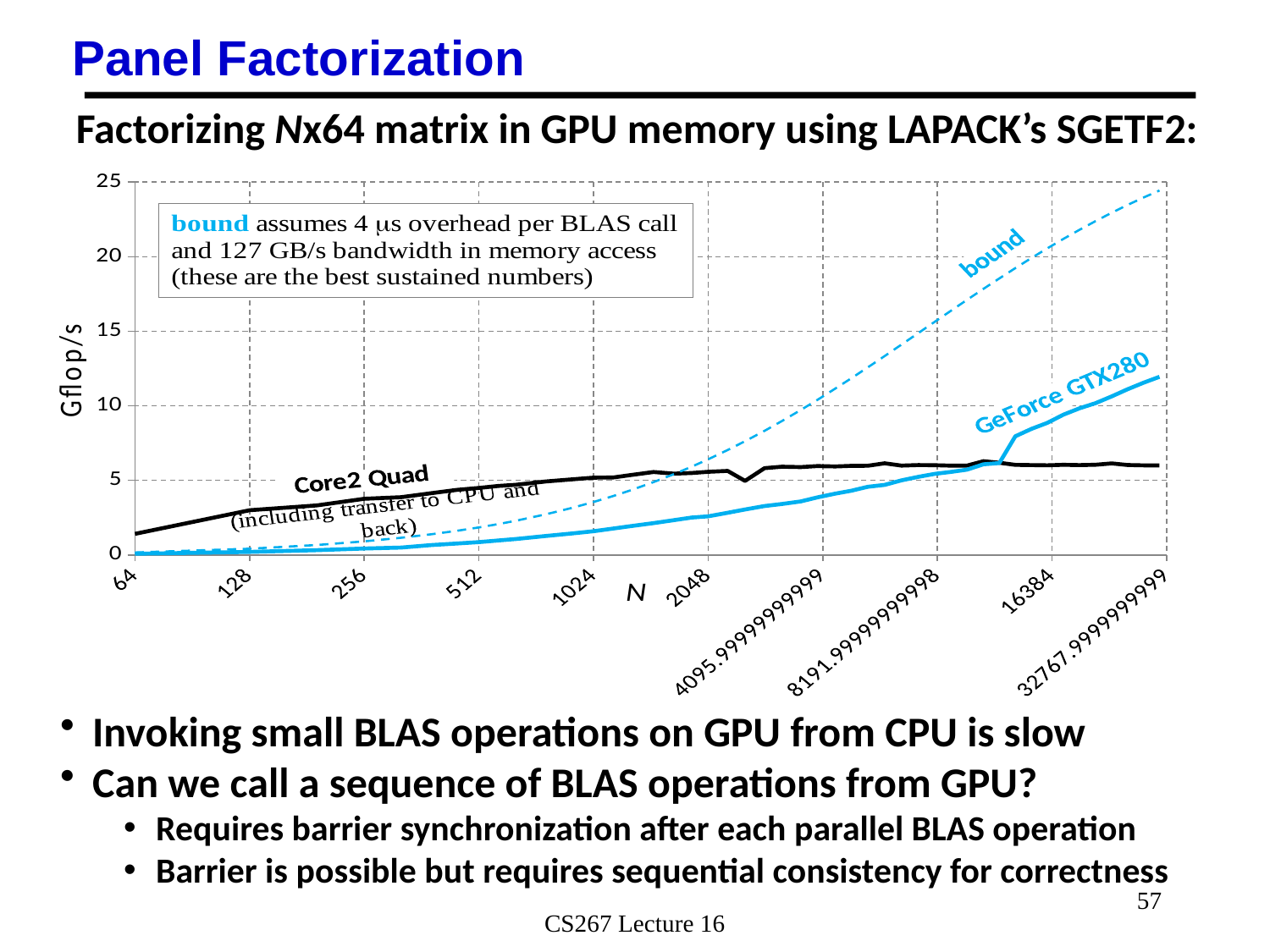
At N = 64, which series has the higher value: Core2 Quad or GeForce GTX280? Core2 Quad Is the value of the bound series at N = 8191.9999999998 greater or less than 15 Gflop/s? greater Is the value of the Core2 Quad series at N = 64 greater or less than 5 Gflop/s? less Is the value of the bound series at the largest N (32767.9999999999) greater or less than 20 Gflop/s? greater How many series are plotted on the chart? 3 At N = 16384, which series has the higher value: GeForce GTX280 or Core2 Quad? GeForce GTX280 What is the label of the x axis? N Does the GeForce GTX280 series rise or fall as N increases? rise What kind of chart is shown on the slide? line chart What is the label of the y axis? Gflop/s